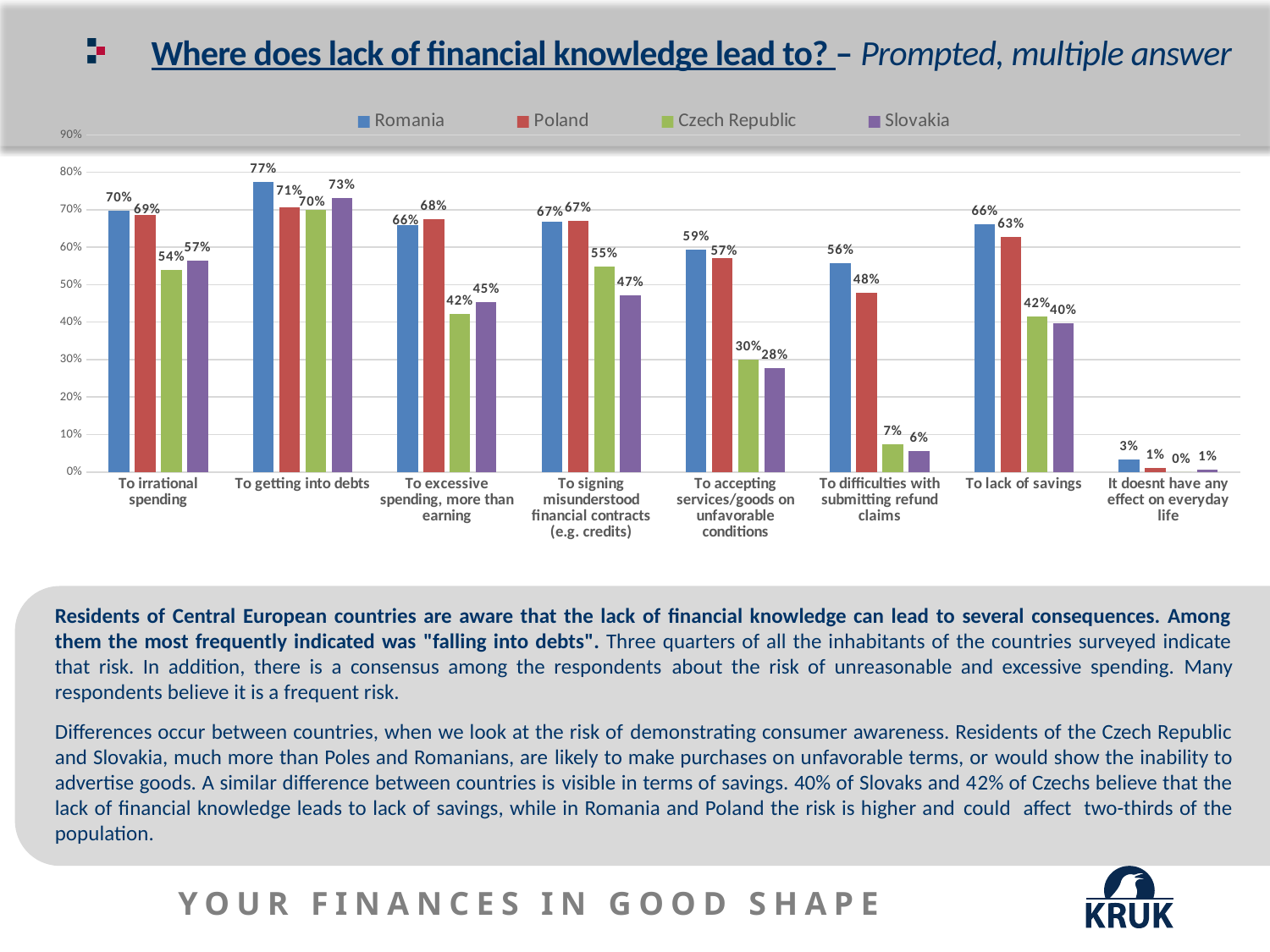
What is the value for the Czech Republic in the 'To difficulties with submitting refund claims' category? 7% What is the value for Slovakia in the 'To lack of savings' category? 40% What type of chart is shown on the slide? Bar chart Which country has the highest value in the 'To getting into debts' category? Romania Which country has the lowest value in the 'To accepting services/goods on unfavorable conditions' category? Slovakia How many series does the legend list? 4 What percentage of Romanian respondents said lack of financial knowledge leads to getting into debts? 77% How many categories (consequences) are shown on the x axis? 8 What is the value for the Czech Republic in the 'It doesnt have any effect on everyday life' category? 0% Which colour represents Poland in the chart? Red What is the difference between Romania's and Poland's values for 'To difficulties with submitting refund claims'? 8% Which is larger: Poland's value for 'To excessive spending, more than earning' or Romania's value in the same category? Poland